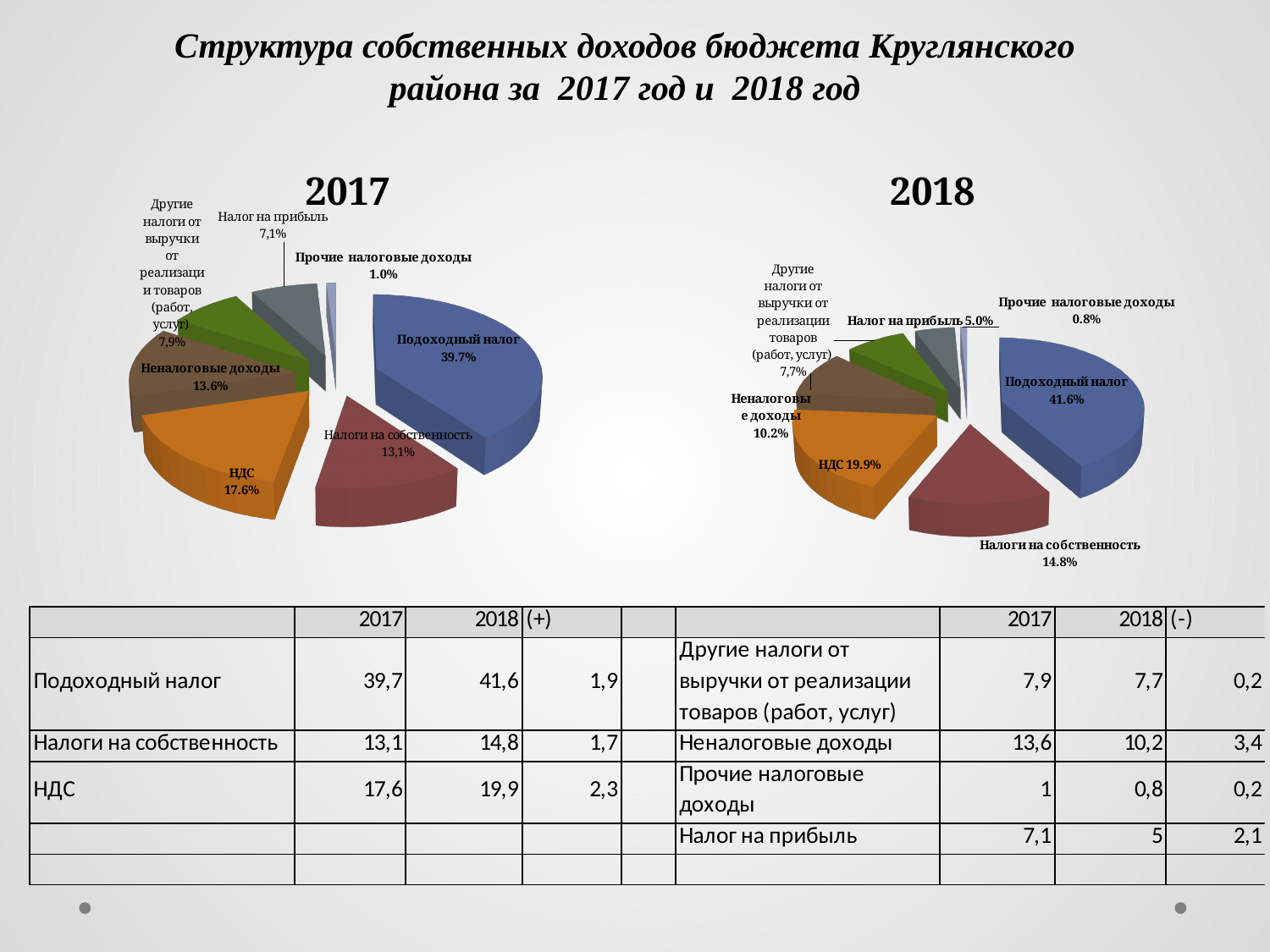
In the 2017 pie chart, which is larger: НДС or Налоги на собственность? НДС How many slices does the 2017 pie chart have? 7 In the 2017 pie chart, what share does Неналоговые доходы have? 13.6% What is the title of the left chart? 2017 In the 2018 pie chart, what share does Налог на прибыль have? 5.0% What type of chart is used for the 2018 data? Pie chart In the 2018 pie chart, what share does НДС have? 19.9% In the 2017 pie chart, what share does Подоходный налог have? 39.7% In the 2018 pie chart, which is larger: Неналоговые доходы or Налоги на собственность? Налоги на собственность In the 2017 pie chart, which category has the smallest share? Прочие налоговые доходы In the 2018 pie chart, which category has the largest share? Подоходный налог In the 2018 pie chart, which category has the smallest share? Прочие налоговые доходы